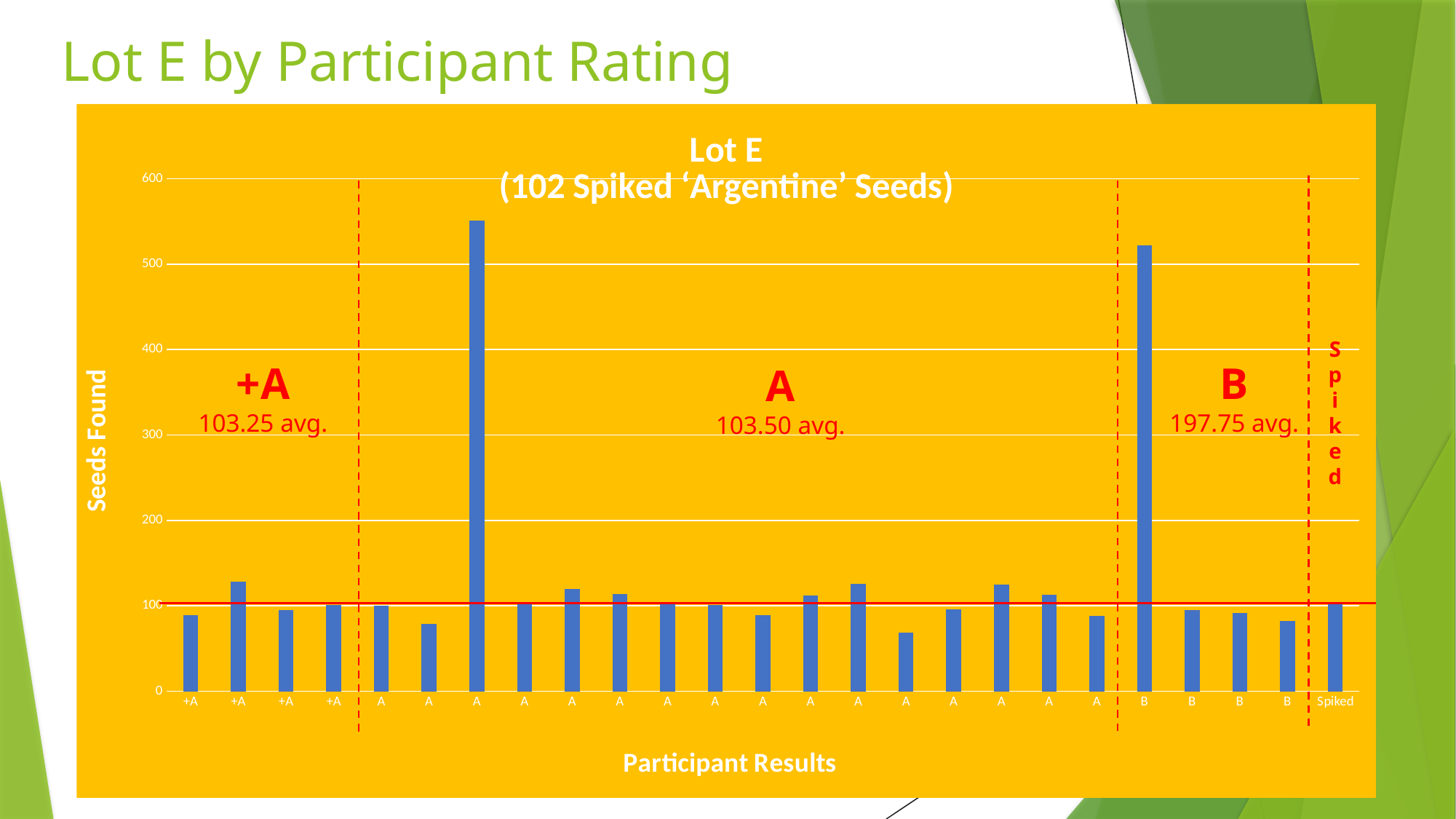
Which rating group has the highest average shown? B Is the value of the tallest bar in the A group greater or less than 500? greater What is the average shown for the +A group? 103.25 avg. What is the average shown for the B group? 197.75 avg. What is the difference between the B group average and the +A group average? 94.50 What is the title of the chart? Lot E (102 Spiked 'Argentine' Seeds) How many bars are plotted in the chart? 25 What is the average shown for the A group? 103.50 avg. Which rating group has the lowest average shown? +A What type of chart is shown on the slide? bar chart How many participants are in the +A rating group? 4 What is the label on the vertical axis of the chart? Seeds Found